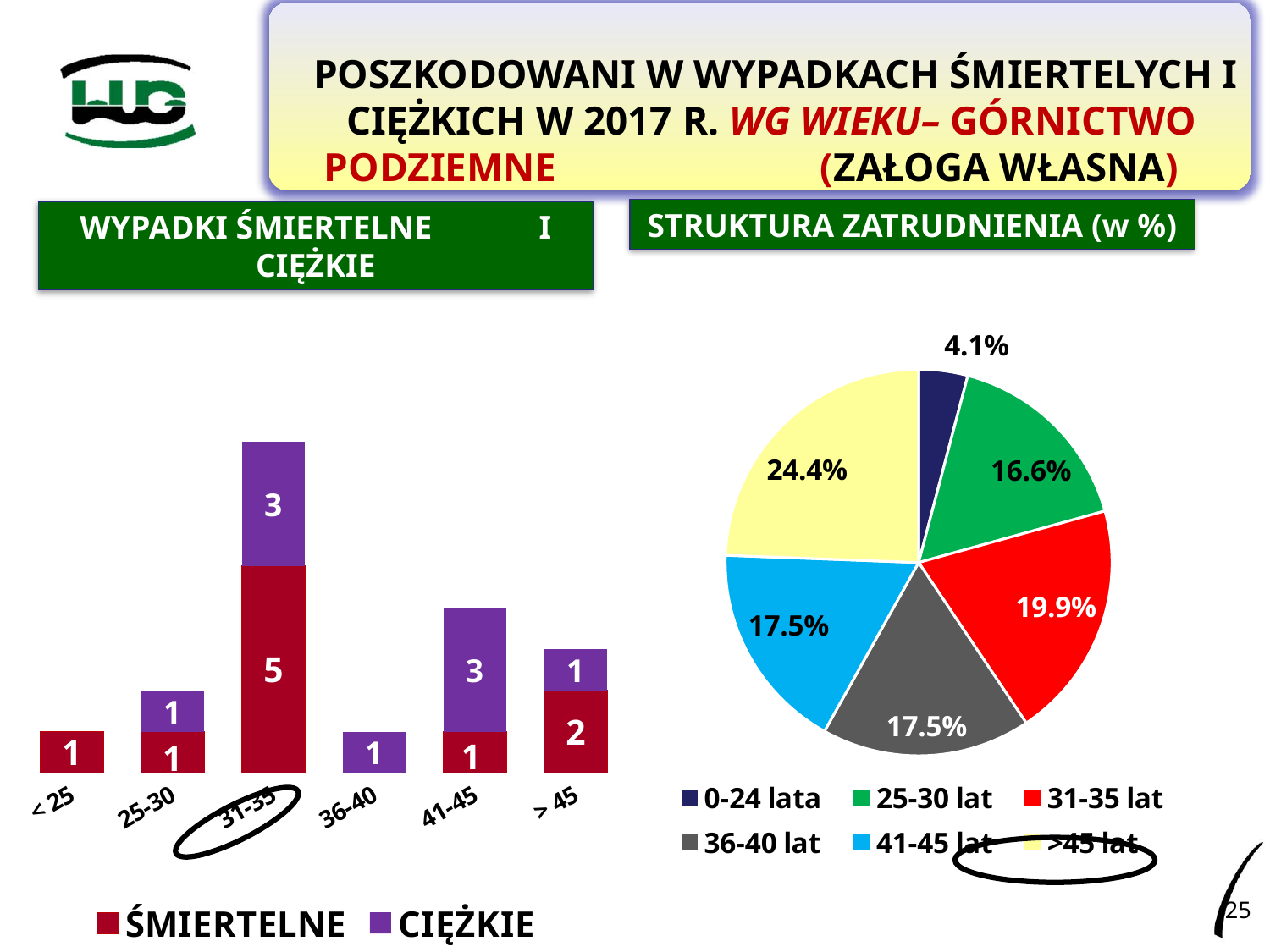
In the pie chart STRUKTURA ZATRUDNIENIA (w %), which age group has the smallest share? 0-24 lata In the bar chart WYPADKI ŚMIERTELNE I CIĘŻKIE, what is the ŚMIERTELNE value for the 31-35 age group? 5 In the bar chart WYPADKI ŚMIERTELNE I CIĘŻKIE, what is the total of the stacked bar for the 31-35 age group? 8 In the bar chart WYPADKI ŚMIERTELNE I CIĘŻKIE, what is the CIĘŻKIE value for the 41-45 age group? 3 In the pie chart STRUKTURA ZATRUDNIENIA (w %), which age group has the largest share? >45 lat In the bar chart WYPADKI ŚMIERTELNE I CIĘŻKIE, which age group has the highest ŚMIERTELNE value? 31-35 In the pie chart STRUKTURA ZATRUDNIENIA (w %), what is the share for 31-35 lat? 19.9% What kind of chart is the one on the left of the slide, WYPADKI ŚMIERTELNE I CIĘŻKIE? Stacked bar chart In the bar chart WYPADKI ŚMIERTELNE I CIĘŻKIE, how many age groups are shown on the x axis? 6 In the bar chart WYPADKI ŚMIERTELNE I CIĘŻKIE, what is the difference between the ŚMIERTELNE values for 31-35 and > 45? 3 In the bar chart WYPADKI ŚMIERTELNE I CIĘŻKIE, how many series does the legend list? 2 In the pie chart STRUKTURA ZATRUDNIENIA (w %), which is larger: the share for 25-30 lat or the share for 36-40 lat? 36-40 lat